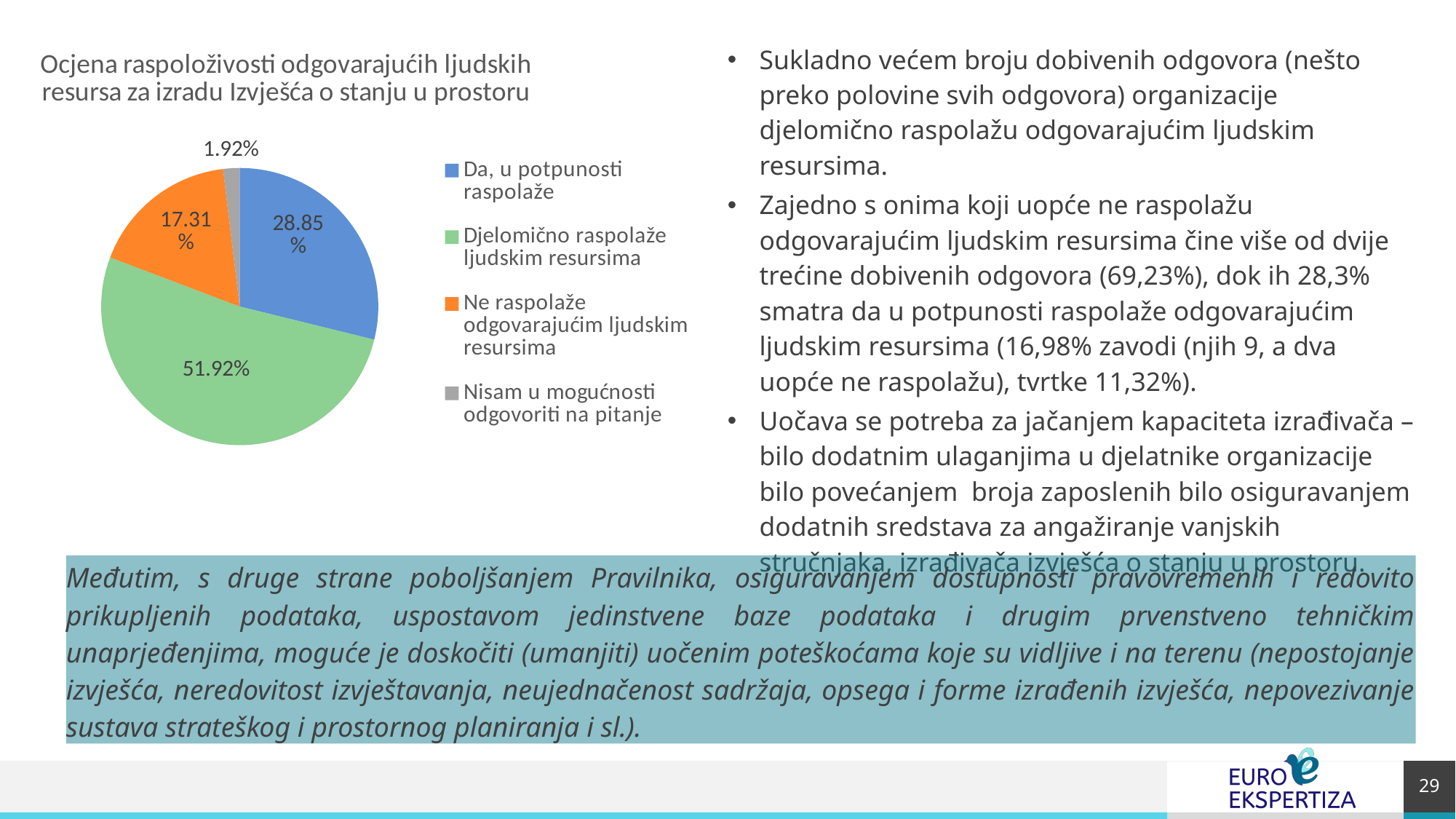
What share of the pie is labelled "Djelomično raspolaže ljudskim resursima"? 51.92% What is the difference in percentage points between "Djelomično raspolaže ljudskim resursima" and "Da, u potpunosti raspolaže"? 23.07 What share of the pie is labelled "Ne raspolaže odgovarajućim ljudskim resursima"? 17.31% Which category has the largest slice of the pie? Djelomično raspolaže ljudskim resursima What colour is the slice for "Ne raspolaže odgovarajućim ljudskim resursima"? orange Which is larger: the slice for "Da, u potpunosti raspolaže" or the slice for "Ne raspolaže odgovarajućim ljudskim resursima"? Da, u potpunosti raspolaže What type of chart is shown on the slide? pie chart How many slices does the pie chart have? 4 What is the title of the chart? Ocjena raspoloživosti odgovarajućih ljudskih resursa za izradu Izvješća o stanju u prostoru What share of the pie is labelled "Da, u potpunosti raspolaže"? 28.85% Which category has the smallest slice of the pie? Nisam u mogućnosti odgovoriti na pitanje